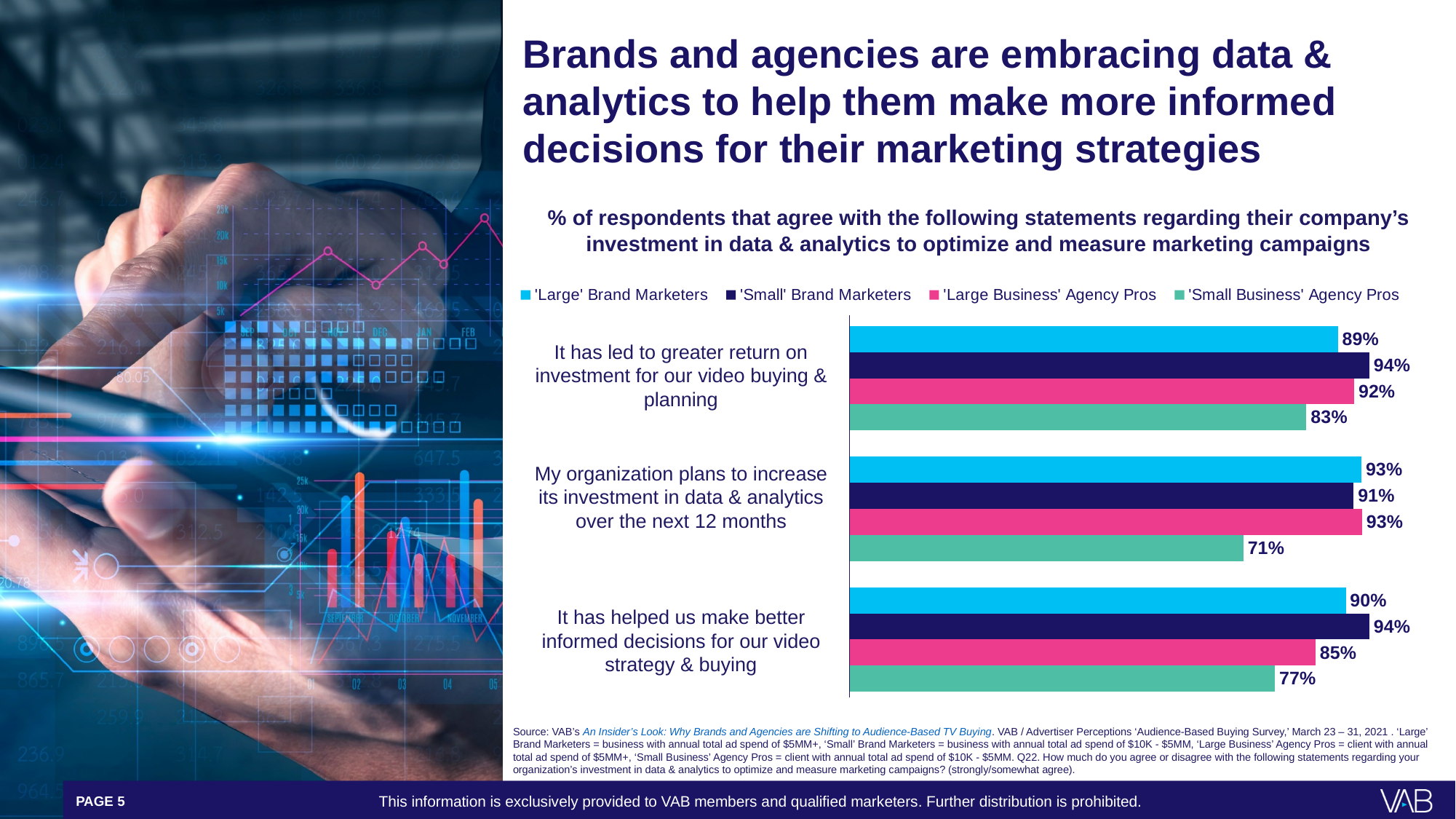
What percentage of 'Large Business' Agency Pros agree that it has helped them make better informed decisions for their video strategy & buying? 85% What percentage of 'Small Business' Agency Pros say their organization plans to increase its investment in data & analytics over the next 12 months? 71% How many series does the legend list? 4 Which group has the lowest share agreeing that their organization plans to increase its investment in data & analytics over the next 12 months? 'Small Business' Agency Pros What is the difference between 'Large Business' Agency Pros and 'Small Business' Agency Pros on the statement that it has led to greater return on investment for their video buying & planning? 9 percentage points What percentage of 'Small' Brand Marketers agree that it has led to greater return on investment for their video buying & planning? 94% How many statements are shown on the chart? 3 For the statement that it has led to greater return on investment for their video buying & planning, which is larger: 'Small' Brand Marketers or 'Large' Brand Marketers? 'Small' Brand Marketers What is the difference between 'Large' Brand Marketers and 'Small Business' Agency Pros on the statement that it has helped them make better informed decisions for their video strategy & buying? 13 percentage points What percentage of 'Large' Brand Marketers agree that it has led to greater return on investment for their video buying & planning? 89% Which group has the highest share agreeing that it has helped them make better informed decisions for their video strategy & buying? 'Small' Brand Marketers What kind of chart is shown on the slide? Bar chart